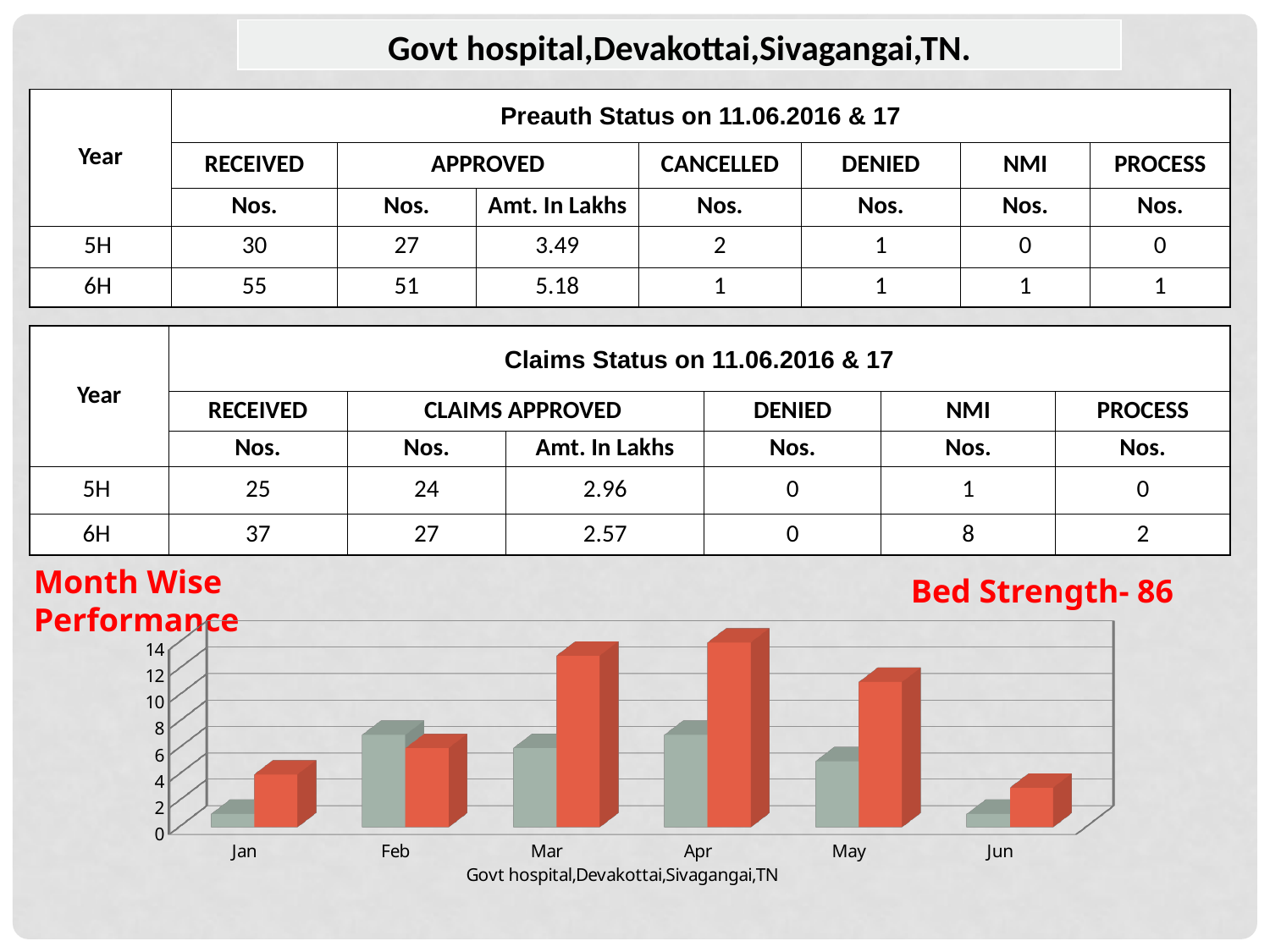
Is the grey bar for Jan greater or less than 2? less Is the red bar for May greater or less than 8? greater Is the red bar for Jun greater or less than 6? less In Mar, which bar is taller, the grey bar or the red bar? the red bar What kind of chart is shown on the slide? bar chart What text appears below the x axis of the chart? Govt hospital,Devakottai,Sivagangai,TN How many months are shown on the x axis of the chart? 6 Which grey bar is taller, Jan or Feb? Feb What is the highest value shown on the chart's vertical axis? 14 Which month has the tallest red bar in the chart? Apr